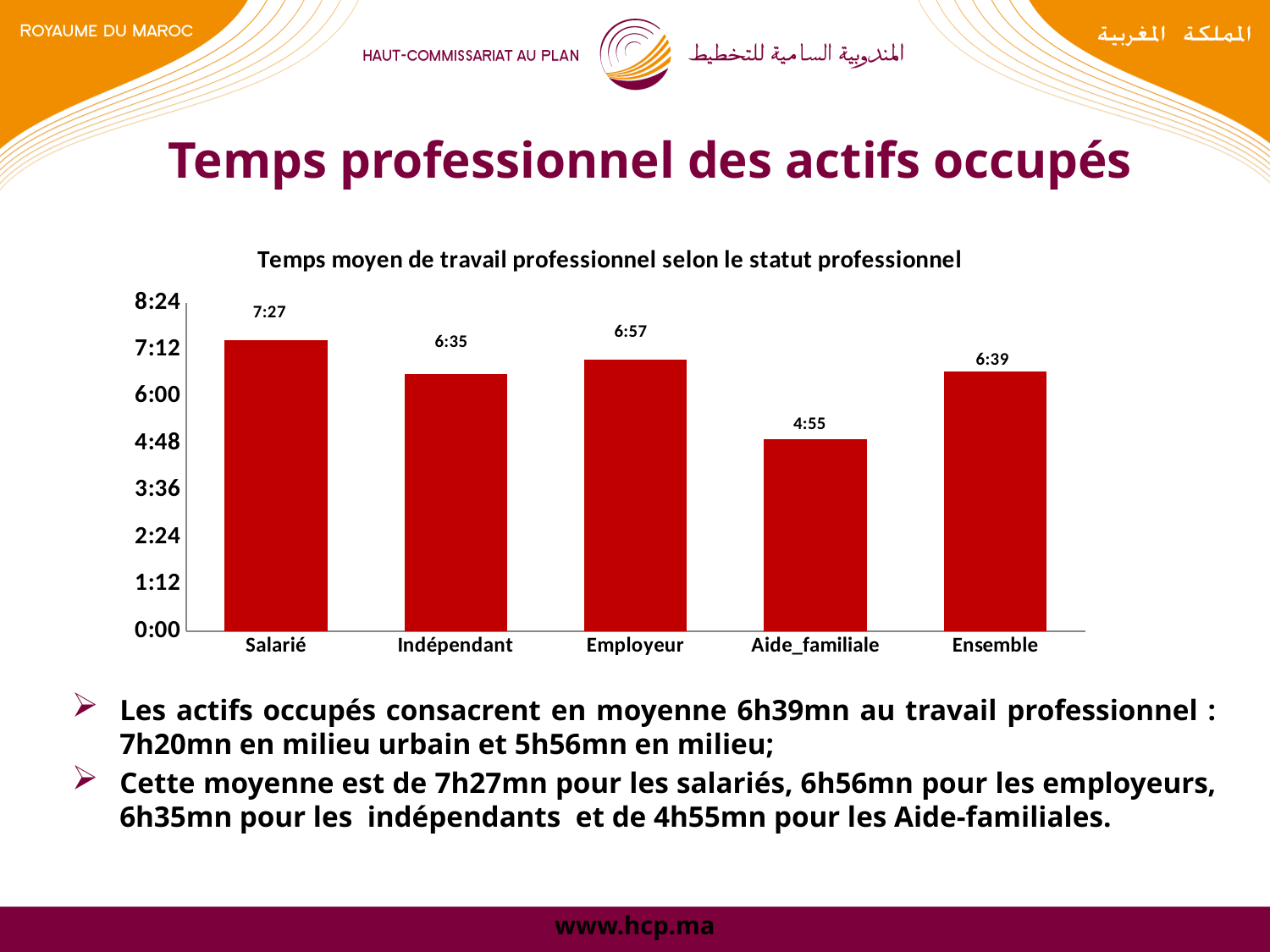
What is the average professional working time for Salarié? 7:27 Which professional status has the lowest average working time? Aide_familiale Is the value for Salarié greater or less than 7:12? greater What type of chart is shown on the slide? Bar chart What is the value for Ensemble in the chart? 6:39 What is the difference between the values for Employeur and Indépendant? 0:22 Which is larger, the value for Employeur or the value for Indépendant? Employeur What is the difference between the values for Salarié and Aide_familiale? 2:32 What value is shown for Employeur? 6:57 What value is shown for Aide_familiale? 4:55 Which professional status has the highest average working time? Salarié How many professional status categories are shown in the chart? 5